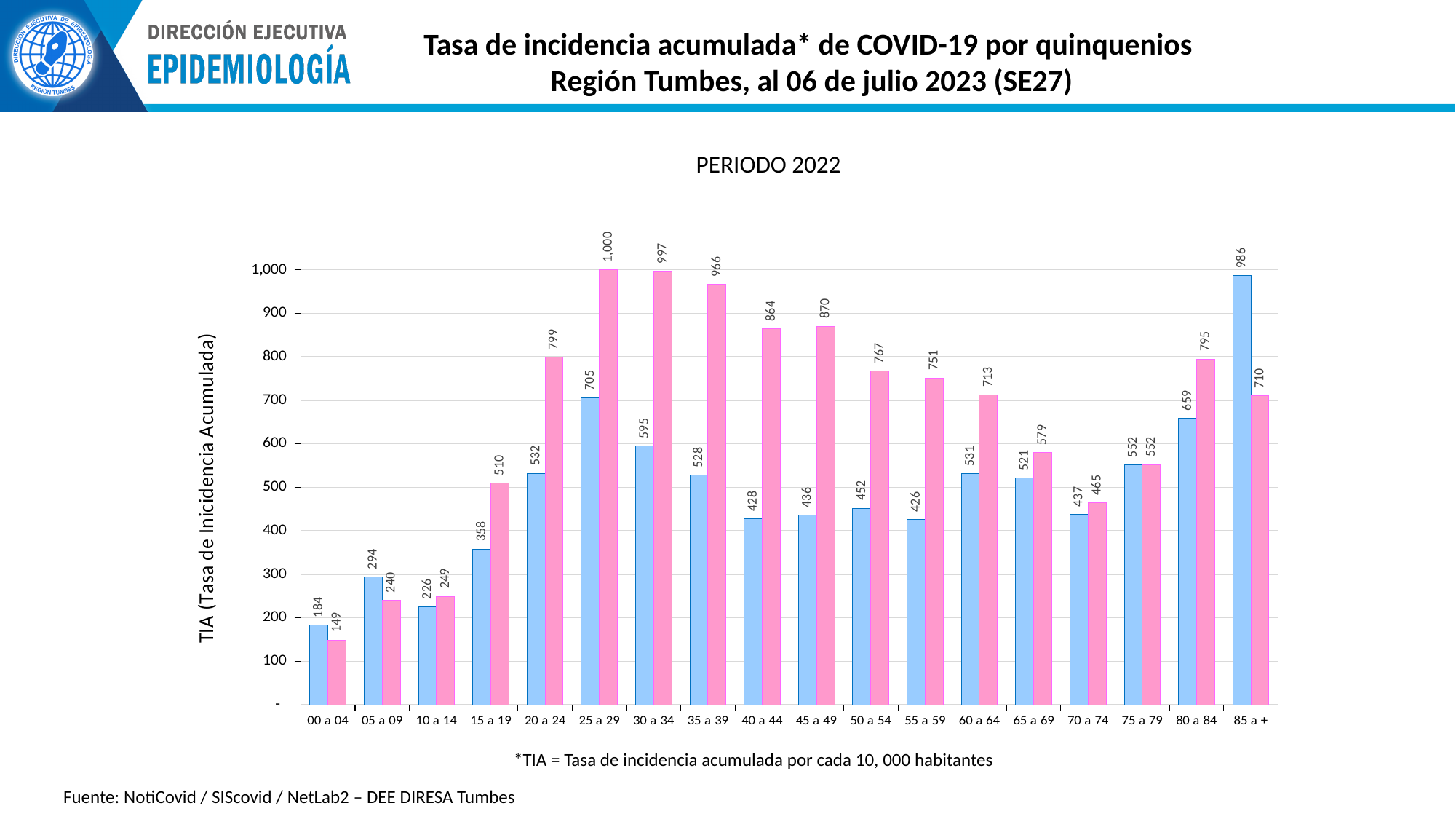
How many age groups are shown on the x axis? 18 What is the value of the blue bar for the 25 a 29 age group? 705 Which age group has the lowest pink bar? 00 a 04 Is the value of the pink bar for the 35 a 39 age group greater or less than 900? greater Which age group has the highest pink bar? 25 a 29 What is the difference between the pink bar and the blue bar for the 20 a 24 age group? 267 Which is larger for the 85 a + age group, the blue bar or the pink bar? the blue bar What is the value of the pink bar for the 40 a 44 age group? 864 Which age group has the highest blue bar? 85 a + What kind of chart is shown on the slide? bar chart What is the title shown above the chart? PERIODO 2022 What is the value of the blue bar for the 75 a 79 age group? 552